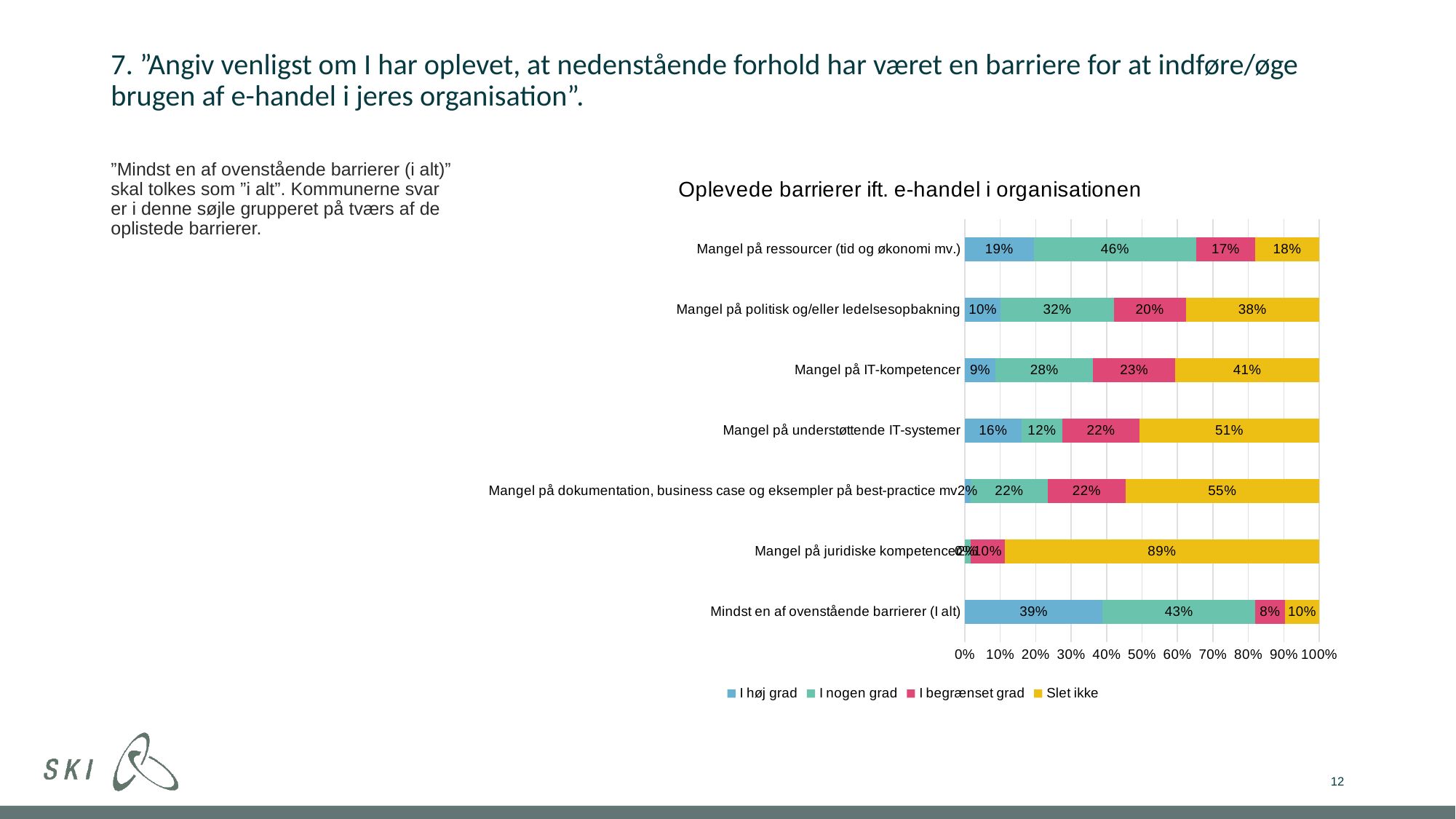
What is the value for "Slet ikke" for "Mangel på juridiske kompetencer"? 89% How much larger is the "Slet ikke" value for "Mangel på understøttende IT-systemer" than for "Mangel på politisk og/eller ledelsesopbakning"? 13 percentage points Which has the larger "I begrænset grad" value: "Mangel på IT-kompetencer" or "Mangel på ressourcer (tid og økonomi mv.)"? Mangel på IT-kompetencer What is the value for "Slet ikke" for "Mangel på IT-kompetencer"? 41% What kind of chart is shown on the slide? Stacked bar chart What is the value for "I nogen grad" for "Mangel på ressourcer (tid og økonomi mv.)"? 46% What is the title of the chart? Oplevede barrierer ift. e-handel i organisationen Which category has the highest value for "I høj grad"? Mindst en af ovenstående barrierer (I alt) What is the value for "I høj grad" for "Mindst en af ovenstående barrierer (I alt)"? 39% How many series does the legend list? 4 How many categories (barriers) are shown in the chart? 7 Which category has the highest value for "Slet ikke"? Mangel på juridiske kompetencer